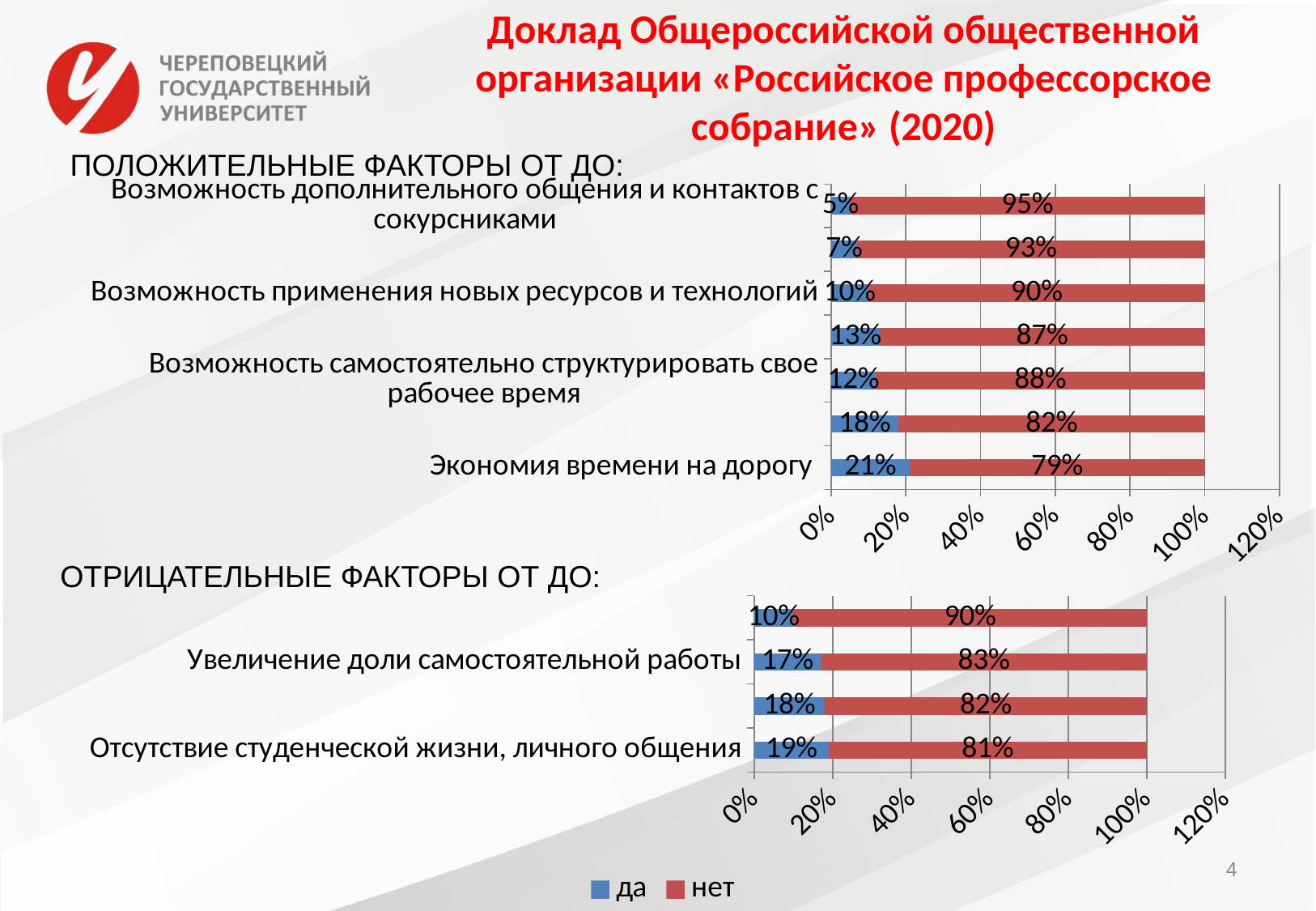
In the chart under «ПОЛОЖИТЕЛЬНЫЕ ФАКТОРЫ ОТ ДО», which labeled category has the highest «да» share? Экономия времени на дорогу In the chart under «ПОЛОЖИТЕЛЬНЫЕ ФАКТОРЫ ОТ ДО», which category has the lowest «да» share? Возможность дополнительного общения и контактов с сокурсниками How many series does the legend at the bottom of the slide list? 2 In the chart under «ПОЛОЖИТЕЛЬНЫЕ ФАКТОРЫ ОТ ДО», what percentage answered «нет» for «Возможность применения новых ресурсов и технологий»? 90% In the chart under «ОТРИЦАТЕЛЬНЫЕ ФАКТОРЫ ОТ ДО», what percentage answered «да» for «Отсутствие студенческой жизни, личного общения»? 19% In the chart under «ПОЛОЖИТЕЛЬНЫЕ ФАКТОРЫ ОТ ДО», how many bars are plotted? 7 In the chart under «ОТРИЦАТЕЛЬНЫЕ ФАКТОРЫ ОТ ДО», what is the total of the stacked bar for «Увеличение доли самостоятельной работы»? 100% In the chart under «ПОЛОЖИТЕЛЬНЫЕ ФАКТОРЫ ОТ ДО», what is the «да» value for «Возможность самостоятельно структурировать свое рабочее время»? 12% In the chart under «ОТРИЦАТЕЛЬНЫЕ ФАКТОРЫ ОТ ДО», what is the difference in «да» share between «Отсутствие студенческой жизни, личного общения» and «Увеличение доли самостоятельной работы»? 2% In the chart under «ОТРИЦАТЕЛЬНЫЕ ФАКТОРЫ ОТ ДО», what percentage answered «нет» for «Увеличение доли самостоятельной работы»? 83% What type of chart is used under «ОТРИЦАТЕЛЬНЫЕ ФАКТОРЫ ОТ ДО»? Stacked bar chart In the chart under «ПОЛОЖИТЕЛЬНЫЕ ФАКТОРЫ ОТ ДО», what percentage answered «да» for «Экономия времени на дорогу»? 21%